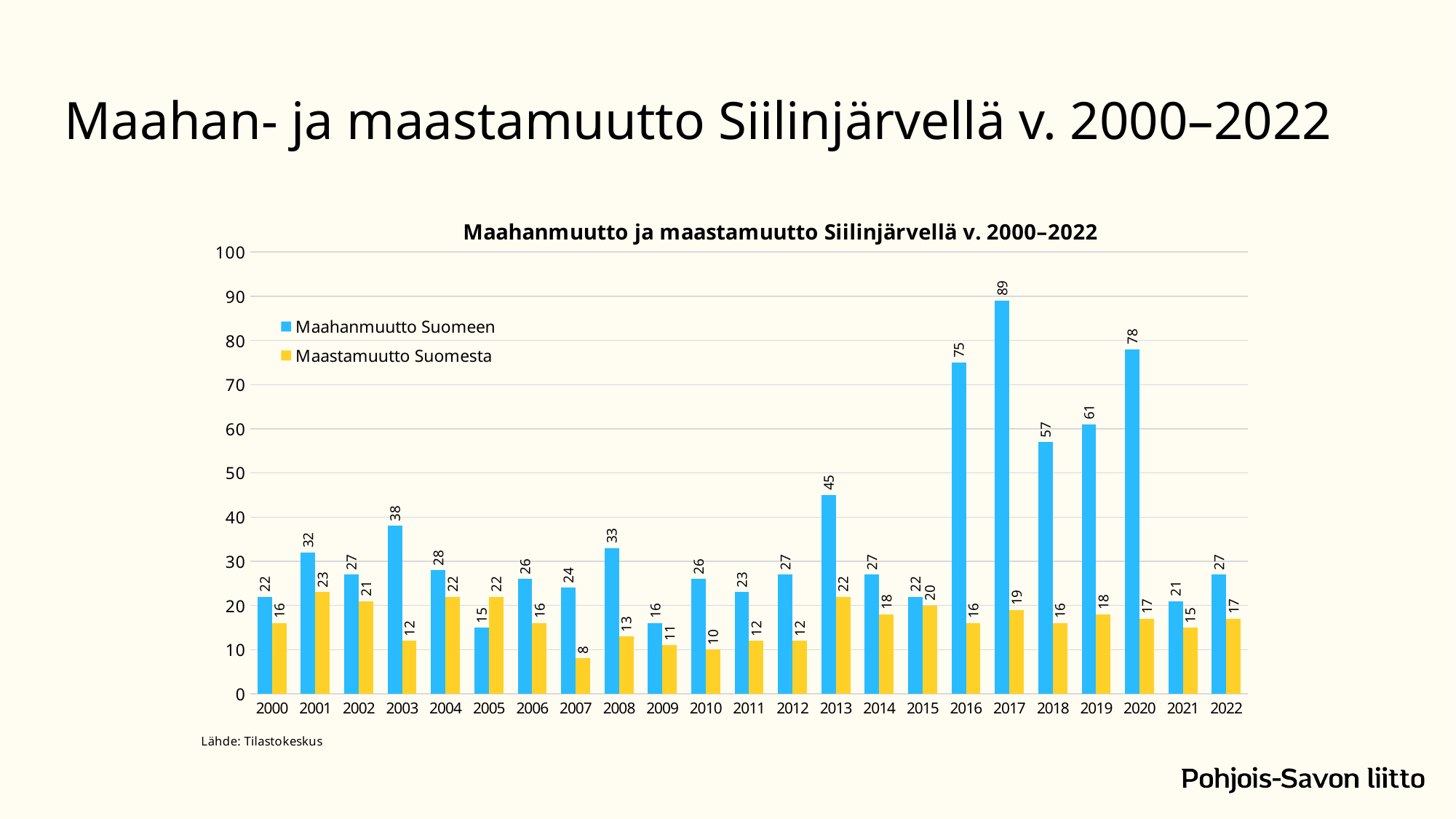
Which is larger in 2005, Maahanmuutto Suomeen or Maastamuutto Suomesta? Maastamuutto Suomesta What is the difference between Maahanmuutto Suomeen and Maastamuutto Suomesta in 2020? 61 What is the value of Maastamuutto Suomesta in 2007? 8 What is the title of the chart? Maahanmuutto ja maastamuutto Siilinjärvellä v. 2000–2022 In which year is Maastamuutto Suomesta lowest? 2007 In which year is Maahanmuutto Suomeen highest? 2017 Is the value for Maahanmuutto Suomeen in 2016 greater or less than 70? greater What kind of chart is shown on the slide? bar chart How many years are shown on the x axis? 23 How many series does the legend list? 2 What is the value of Maahanmuutto Suomeen in 2017? 89 What is the value of Maahanmuutto Suomeen in 2005? 15